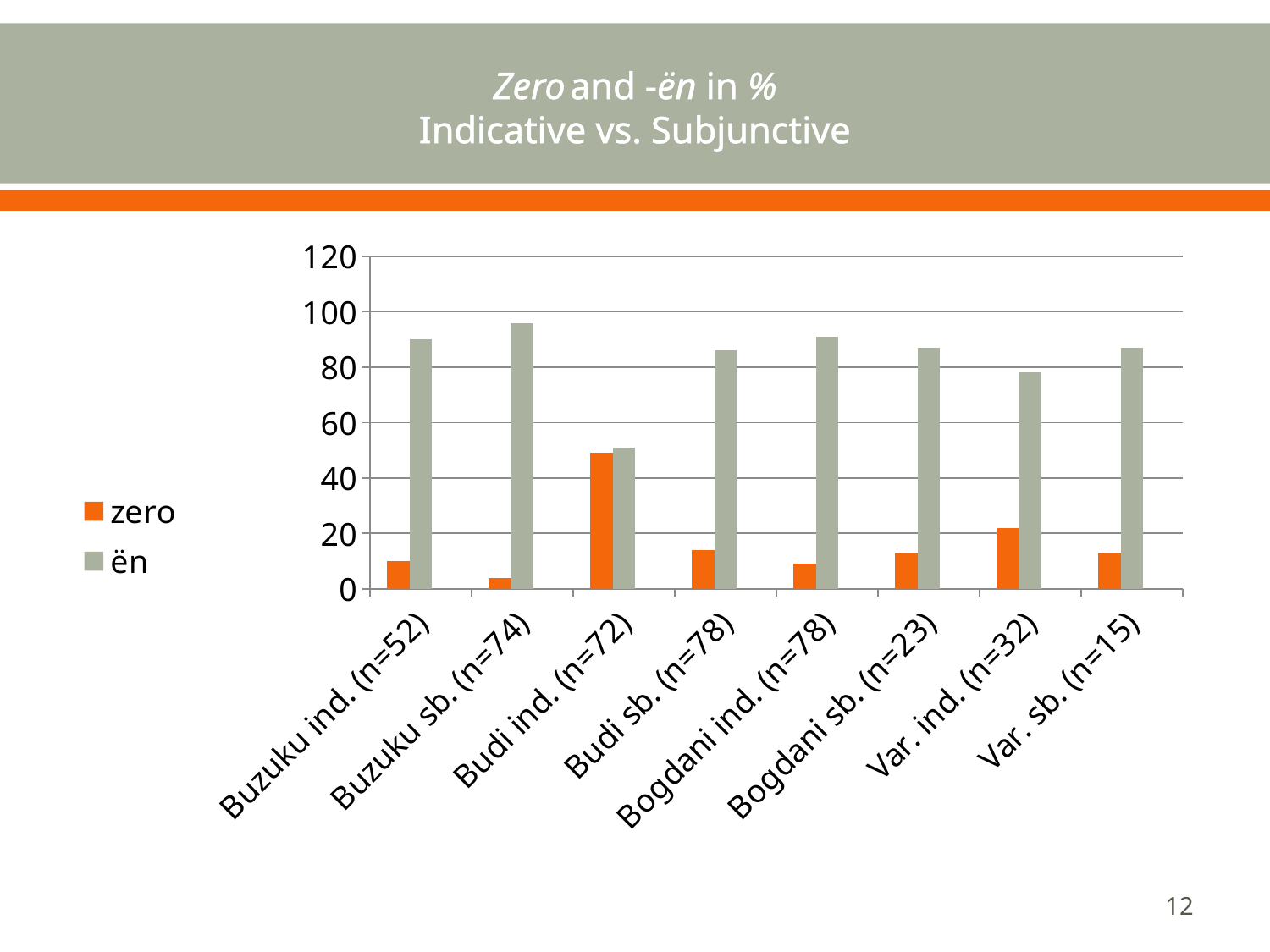
Is the zero value for Budi ind. (n=72) greater or less than 40? greater Which category has the highest value for the ën series? Buzuku sb. (n=74) Is the ën value for Buzuku sb. (n=74) greater or less than 80? greater What colour are the bars for the zero series? orange How many series does the legend list? 2 Is the zero value for Buzuku ind. (n=52) greater or less than 20? less Which is larger, the zero value for Var. ind. (n=32) or the zero value for Bogdani sb. (n=23)? Var. ind. (n=32) What kind of chart is shown on the slide? bar chart Which category has the lowest value for the ën series? Budi ind. (n=72) How many categories are shown on the x axis? 8 Which category has the lowest value for the zero series? Buzuku sb. (n=74) Which category has the highest value for the zero series? Budi ind. (n=72)